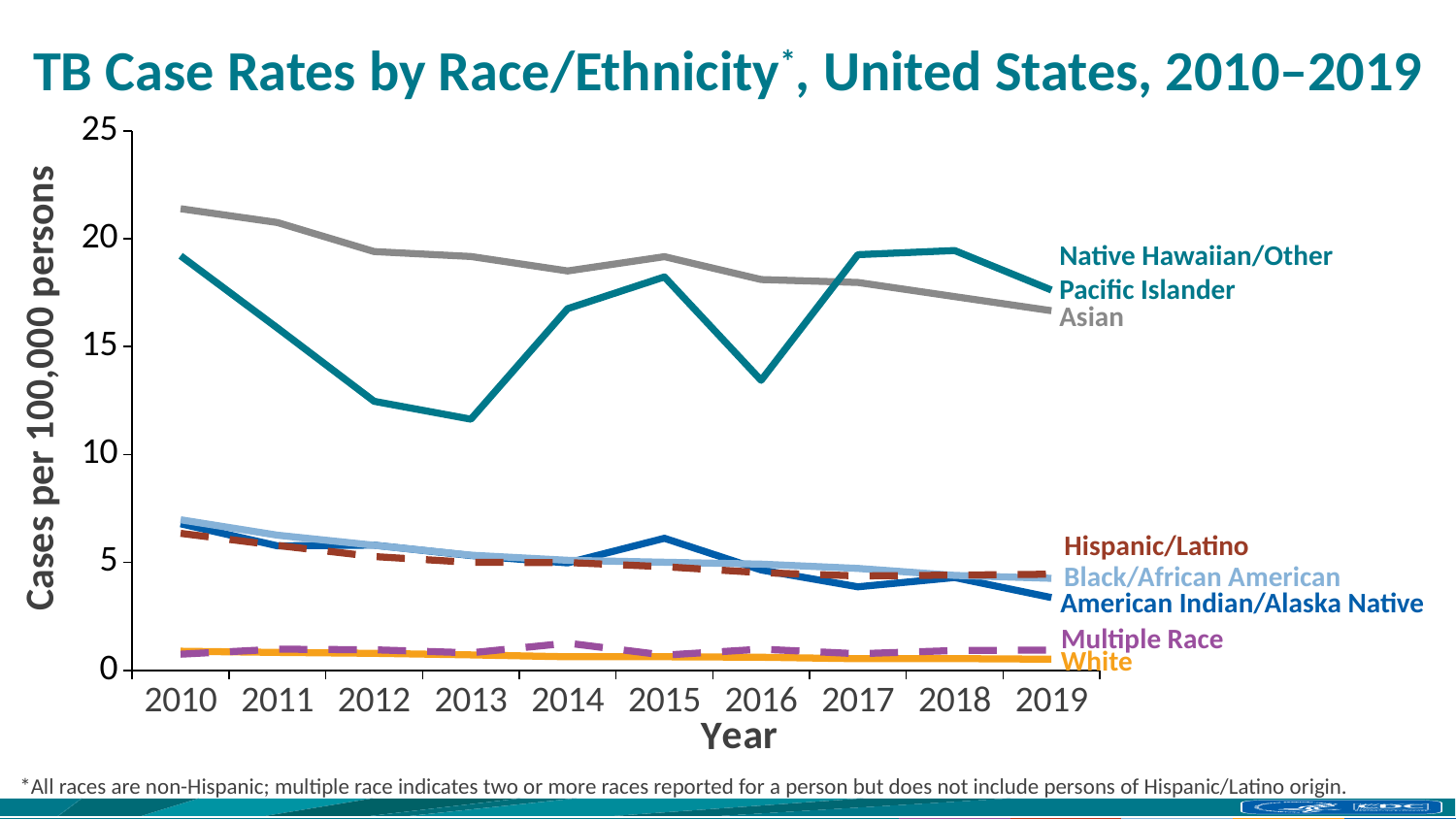
What kind of chart is shown on the slide? line chart What is the label on the y axis of the chart? Cases per 100,000 persons Which race/ethnicity group had the highest TB case rate in 2010? Asian How many race/ethnicity groups are plotted on the chart? 7 Is the TB case rate for Asian persons in 2019 greater or less than 15? greater Which race/ethnicity group had the lowest TB case rate in 2019? White In which year was the TB case rate for Native Hawaiian/Other Pacific Islander lowest? 2013 Does the TB case rate for Asian persons rise or fall from 2010 to 2019? fall In 2017, which group had the higher TB case rate: Native Hawaiian/Other Pacific Islander or Asian? Native Hawaiian/Other Pacific Islander How many years are shown along the x axis? 10 Is the TB case rate for Native Hawaiian/Other Pacific Islander persons in 2016 greater or less than 15? less Is the TB case rate for Asian persons in 2010 greater or less than 20? greater